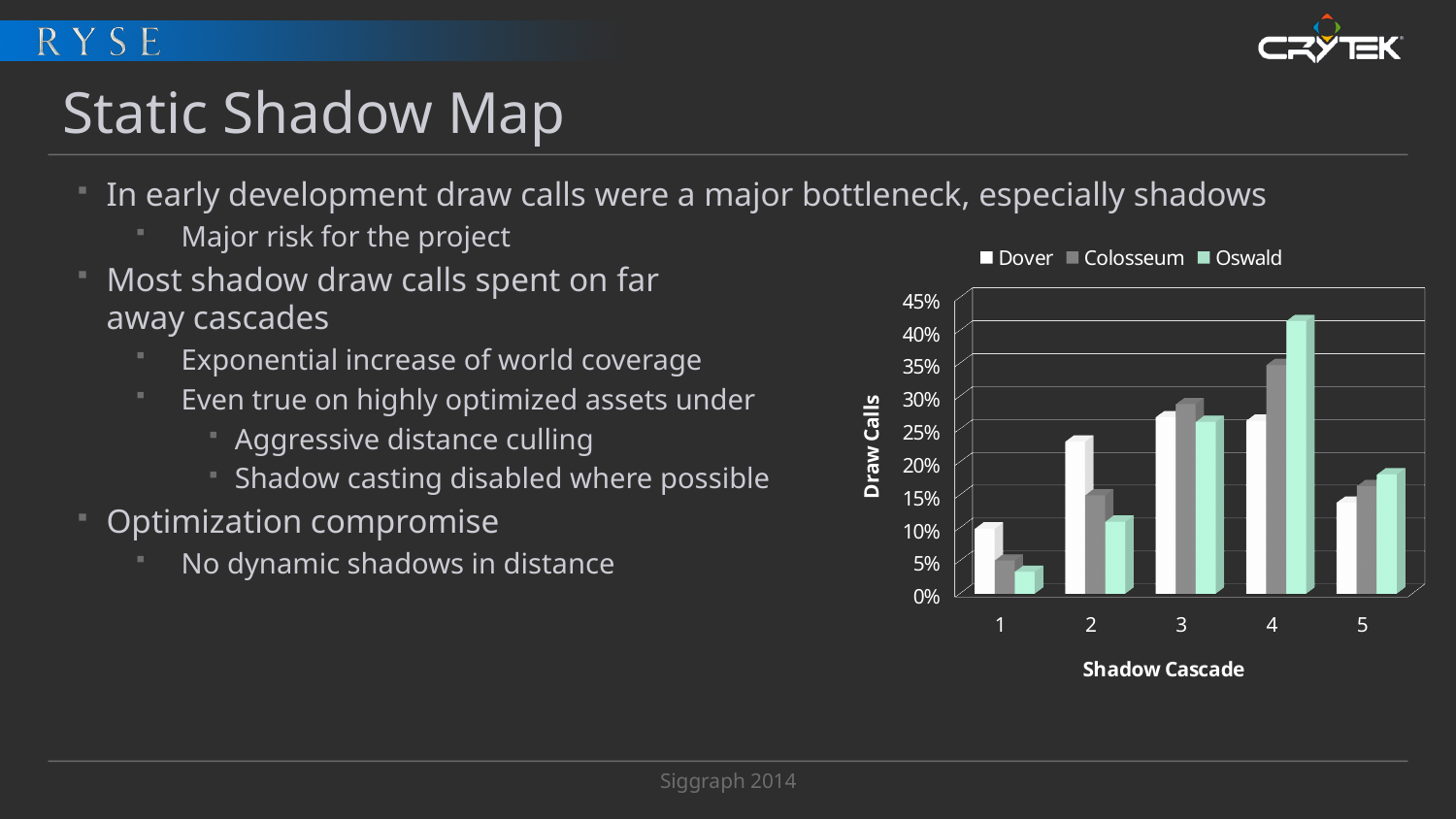
Which series has the lowest bar in the chart, and at which shadow cascade? Oswald at cascade 1 At shadow cascade 4, which is larger: Dover or Oswald? Oswald What kind of chart is shown on the slide? bar chart What is the title of the chart's vertical axis? Draw Calls At shadow cascade 2, which is larger: Dover or Oswald? Dover Which series has the highest bar in the chart, and at which shadow cascade? Oswald at cascade 4 How many shadow cascade categories are shown on the x axis? 5 Is the Colosseum value for shadow cascade 4 greater or less than 30%? greater Is the Dover value for shadow cascade 2 greater or less than 20%? greater Is the Colosseum value for shadow cascade 1 greater or less than 10%? less How many series does the chart legend list? 3